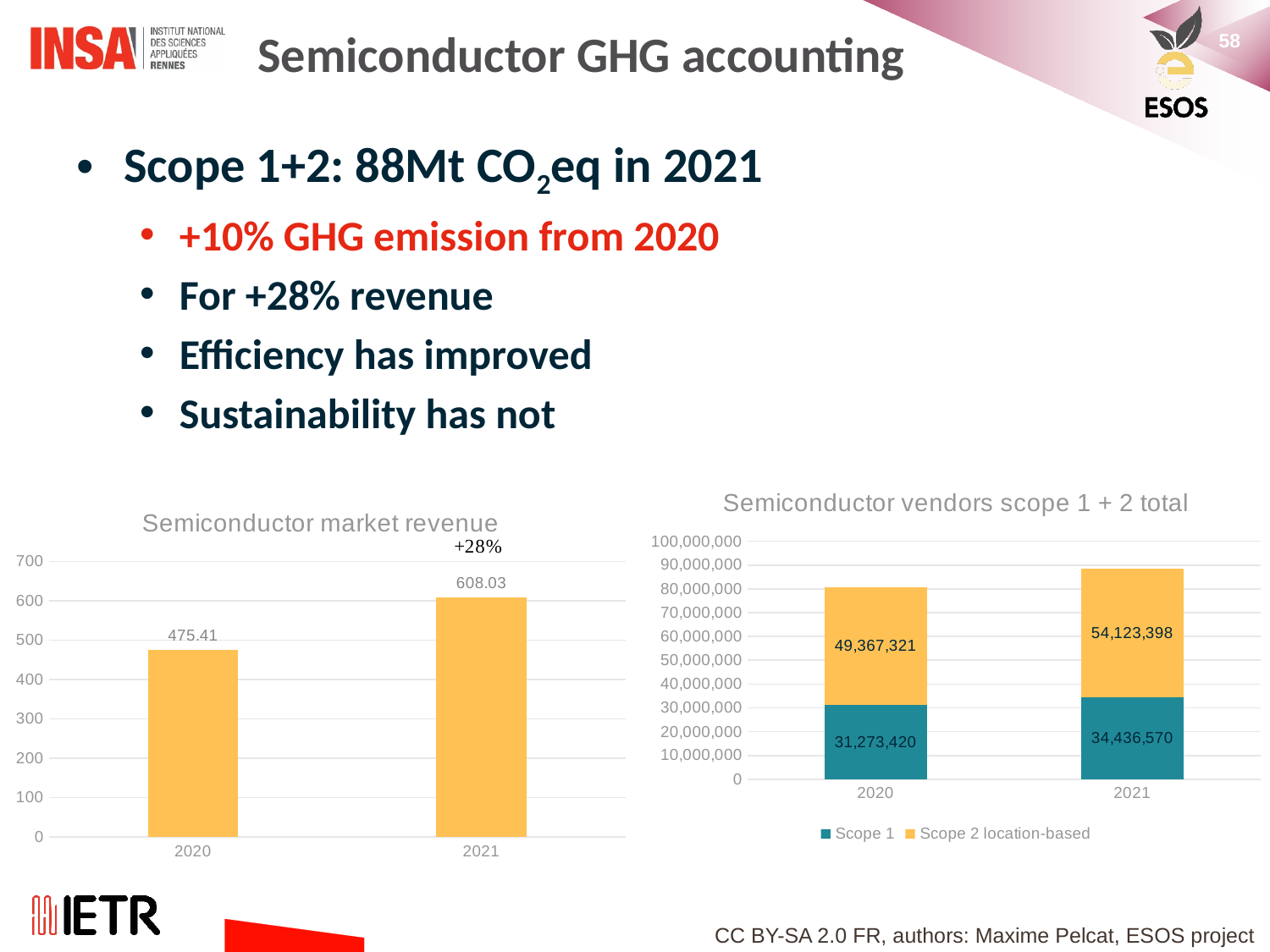
In the 'Semiconductor vendors scope 1 + 2 total' chart, what is the Scope 2 location-based value for 2021? 54,123,398 In the 'Semiconductor market revenue' chart, what is the value for 2020? 475.41 In the 'Semiconductor market revenue' chart, what is the difference between the 2021 and 2020 values? 132.62 In the 'Semiconductor vendors scope 1 + 2 total' chart, how much did Scope 1 increase from 2020 to 2021? 3,163,150 In the 'Semiconductor market revenue' chart, what percentage change is annotated above the 2021 bar? +28% In the 'Semiconductor vendors scope 1 + 2 total' chart, what is the total of the stacked bar for 2021? 88,559,968 In the 'Semiconductor market revenue' chart, what is the value for 2021? 608.03 What kind of chart is the 'Semiconductor vendors scope 1 + 2 total' chart? stacked bar chart In the 'Semiconductor vendors scope 1 + 2 total' chart, how many series does the legend list? 2 In the 'Semiconductor vendors scope 1 + 2 total' chart, what is the total of the stacked bar for 2020? 80,640,741 In the 'Semiconductor vendors scope 1 + 2 total' chart, what is the Scope 1 value for 2020? 31,273,420 In the 'Semiconductor market revenue' chart, do the values rise or fall from 2020 to 2021? rise